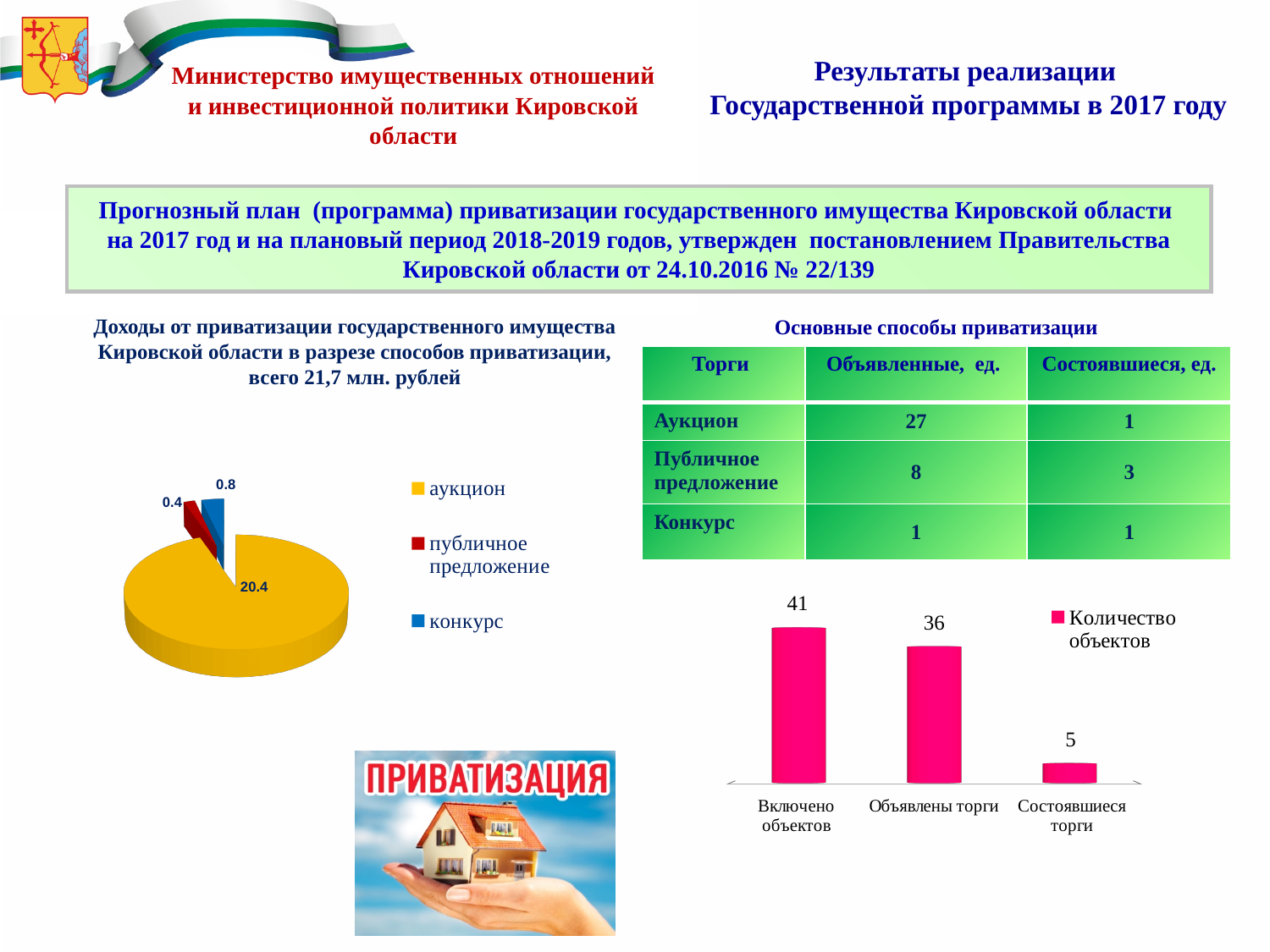
In the pie chart on the left, how many categories does the legend list? 3 What type of chart is the chart at the bottom right of the slide? bar chart In the bar chart at the bottom right, what series name does the legend show? Количество объектов In the bar chart at the bottom right, what is the value for Объявлены торги? 36 In the pie chart on the left, what is the value for конкурс? 0.8 In the pie chart on the left, what is the difference between the values for аукцион and конкурс? 19.6 In the pie chart on the left, which category has the smallest slice? публичное предложение In the pie chart on the left, which category has the largest slice? аукцион In the bar chart at the bottom right, what is the difference between Включено объектов and Состоявшиеся торги? 36 In the pie chart on the left, what is the value for публичное предложение? 0.4 What type of chart is the chart on the left of the slide (Доходы от приватизации государственного имущества)? pie chart In the pie chart on the left, what is the value for аукцион? 20.4